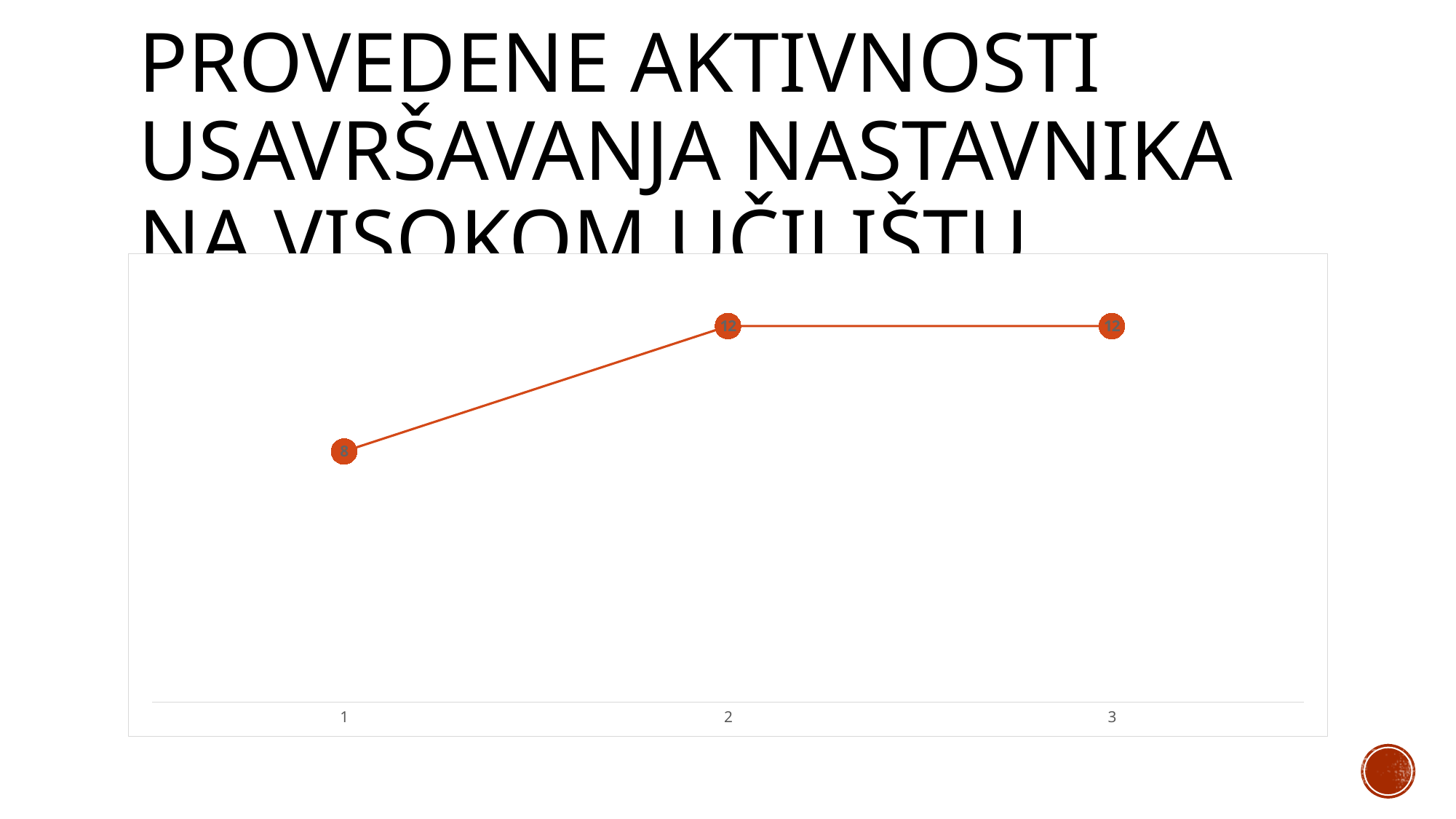
Does the value change between category 2 and category 3? no, it stays at 12 How many data points are plotted on the chart? 3 Do the values rise or fall from category 1 to category 2? rise What is the value plotted at category 2? 12 What colour is the line on the chart? orange What is the value plotted at category 3? 12 What is the value plotted at category 1? 8 What is the highest value shown on the chart? 12 Which category has the lowest value? 1 What is the difference between the values at category 2 and category 1? 4 What kind of chart is shown on the slide? line chart Which is larger, the value at category 1 or the value at category 2? category 2